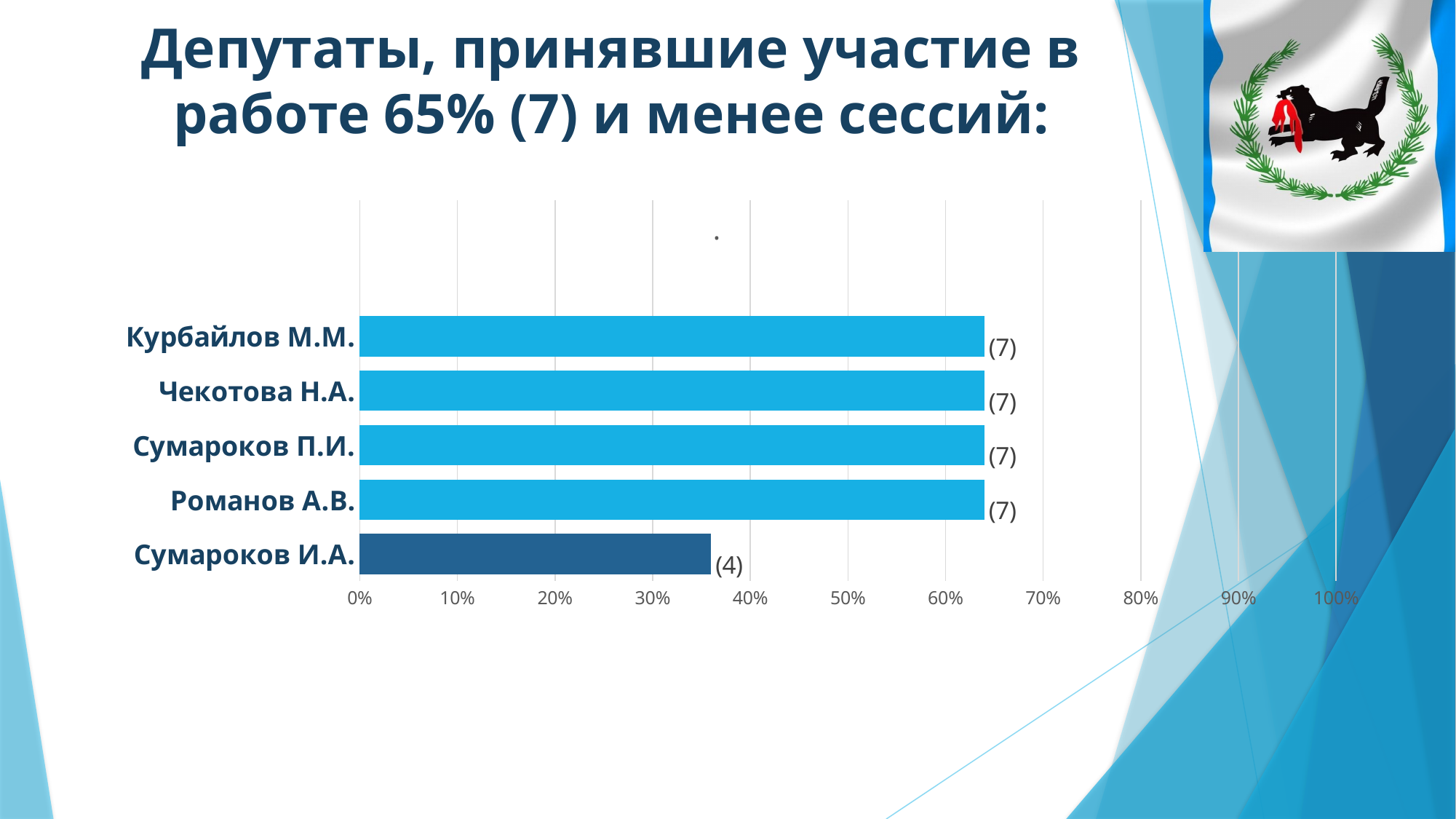
Which is larger, the value for Чекотова Н.А. or the value for Сумароков И.А.? Чекотова Н.А. Is the value for Сумароков П.И. greater or less than 70%? less What data label is shown next to the bar for Курбайлов М.М.? (7) Which deputy's bar is drawn in a darker blue than the others? Сумароков И.А. Is the value for Сумароков И.А. greater or less than 40%? less How many deputies are shown in the chart? 5 Which deputy has the lowest value in the chart? Сумароков И.А. What kind of chart is shown on the slide? bar chart What data label is shown next to the bar for Романов А.В.? (7) Is the value for Сумароков И.А. greater or less than 30%? greater What data label is shown next to the bar for Сумароков И.А.? (4)